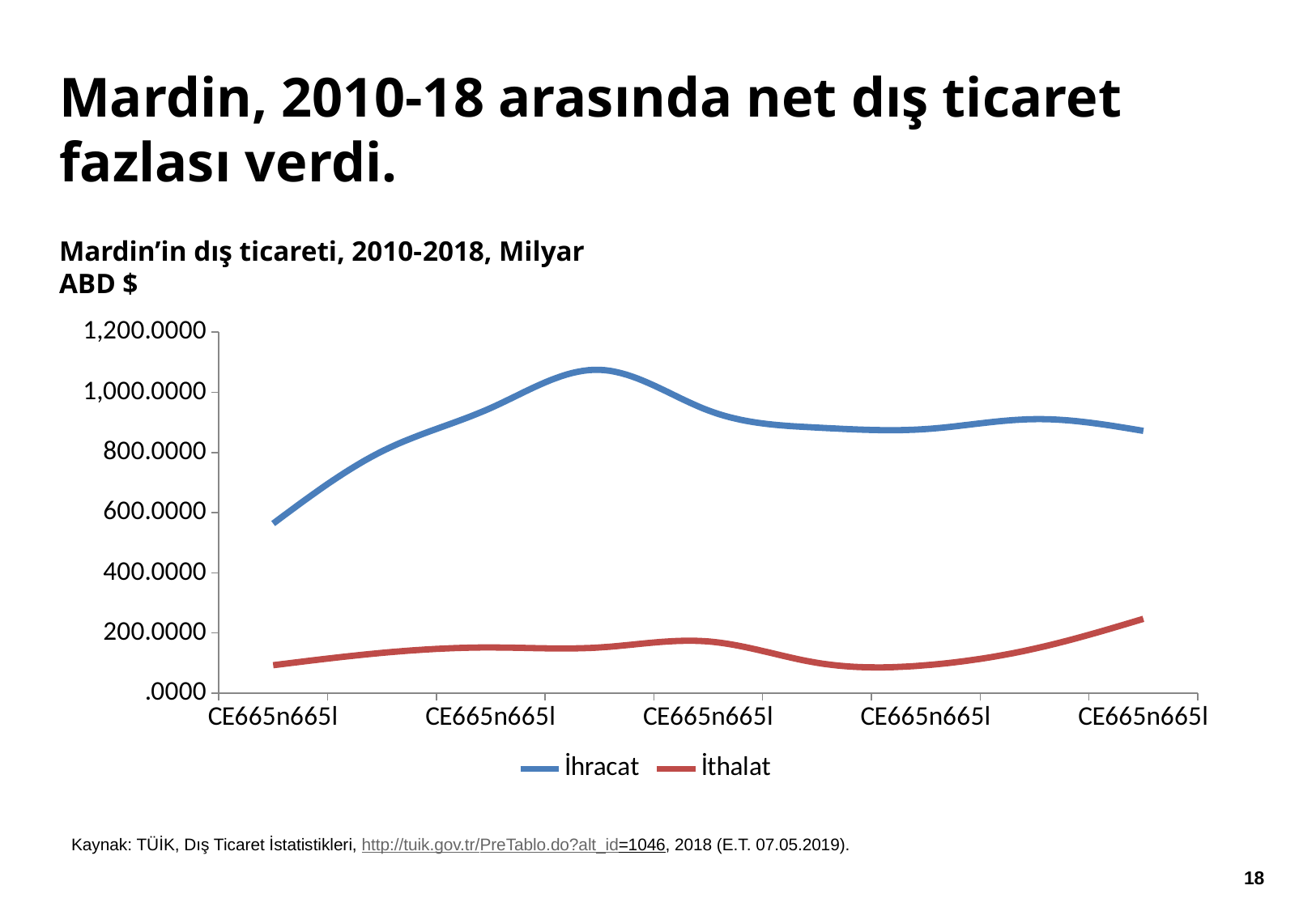
Is the value of İthalat at the first point greater or less than 200? less What is the title of the chart? Mardin'in dış ticareti, 2010-2018, Milyar ABD $ Is the peak value of the İhracat line greater or less than 1,000? greater What kind of chart is shown on the slide? line chart Is the value of İhracat at the last point greater or less than 800? greater Which series reaches the highest value on the chart? İhracat What are the two series named in the legend? İhracat and İthalat How many series does the legend list? 2 Does the İthalat line end higher or lower than it starts? higher Which series has the higher values throughout the chart, İhracat or İthalat? İhracat Does the İhracat line end higher or lower than it starts? higher